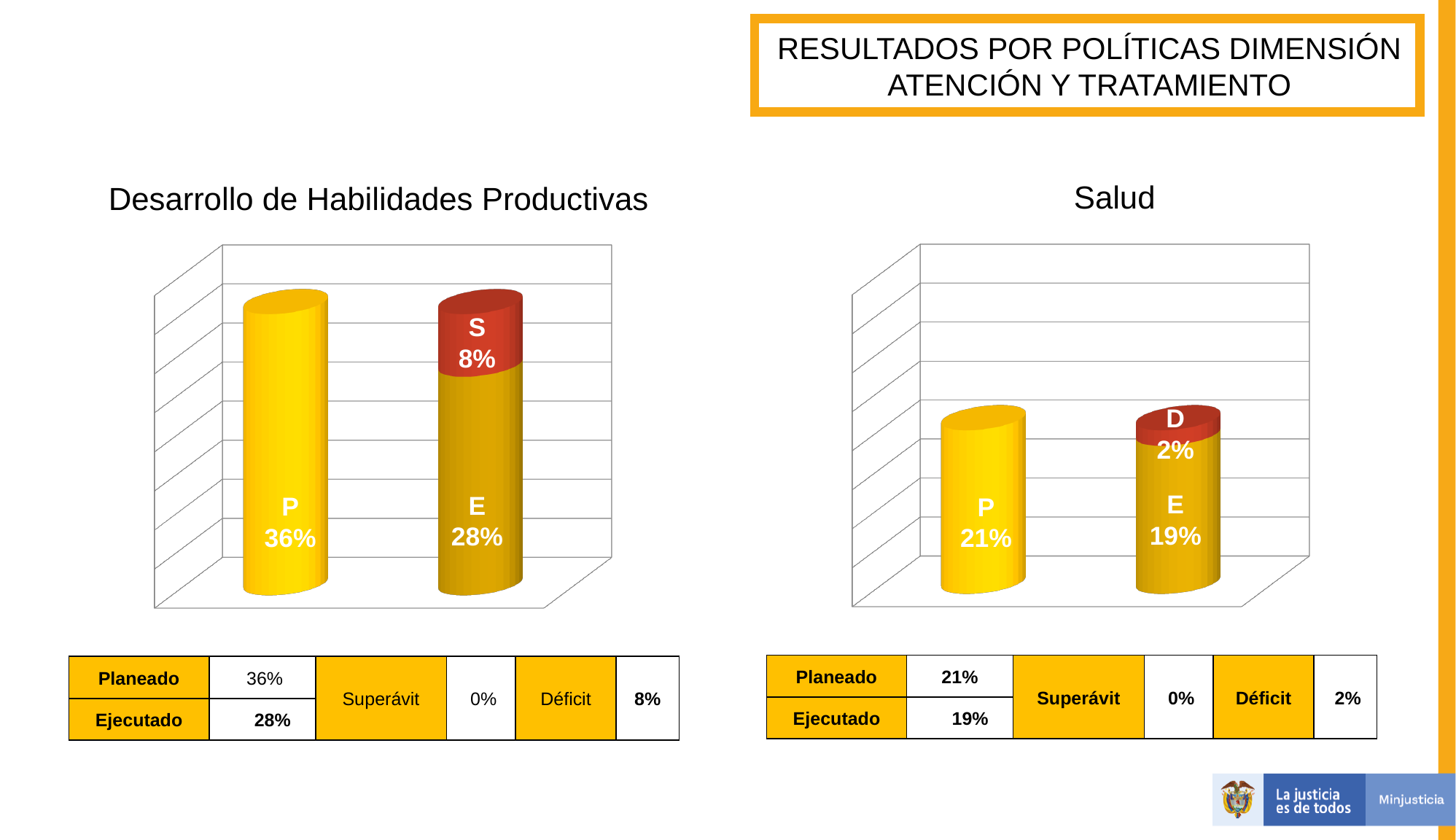
In the 'Salud' chart, what is the value of the P bar? 21% In the 'Salud' chart, what is the difference between the P value and the E value? 2% What colour is the D segment in the 'Salud' chart? Red In the 'Desarrollo de Habilidades Productivas' chart, what is the value of the E bar? 28% In the 'Desarrollo de Habilidades Productivas' chart, what value is shown for the red S segment? 8% In the 'Salud' chart, what value is shown for the red D segment? 2% In the 'Salud' chart, what is the value of the E bar? 19% In the 'Desarrollo de Habilidades Productivas' chart, what is the difference between the P value and the E value? 8% What kind of chart is the 'Salud' chart? Bar chart In the 'Desarrollo de Habilidades Productivas' chart, what is the total of the stacked E bar (E plus S)? 36% In the 'Desarrollo de Habilidades Productivas' chart, what is the value of the P bar? 36%